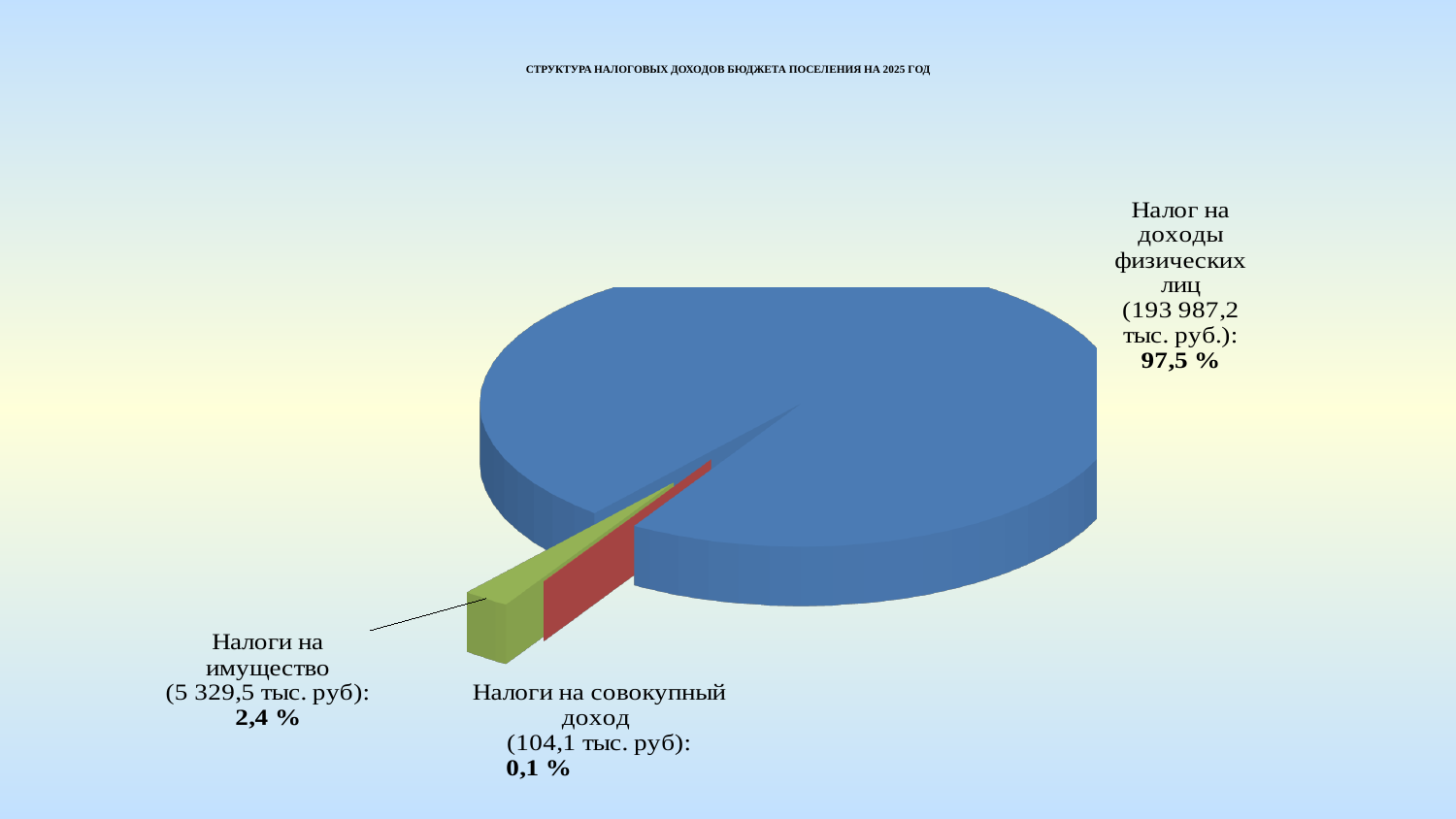
What is the value in тыс. руб. for 'Налог на доходы физических лиц'? 193 987,2 тыс. руб. What is the difference in percentage points between the shares of 'Налог на доходы физических лиц' and 'Налоги на имущество'? 95,1 % What share of the pie does 'Налоги на имущество' represent? 2,4 % What share of the pie does 'Налоги на совокупный доход' represent? 0,1 % Which category has the largest share of the pie? Налог на доходы физических лиц Which category has the smallest share of the pie? Налоги на совокупный доход How many slices does the pie chart have? 3 What type of chart is shown on the slide? Pie chart What is the value in тыс. руб. for 'Налоги на имущество'? 5 329,5 тыс. руб. What is the title of the chart? СТРУКТУРА НАЛОГОВЫХ ДОХОДОВ БЮДЖЕТА ПОСЕЛЕНИЯ НА 2025 ГОД What is the value in тыс. руб. for 'Налоги на совокупный доход'? 104,1 тыс. руб. What share of the pie does 'Налог на доходы физических лиц' represent? 97,5 %